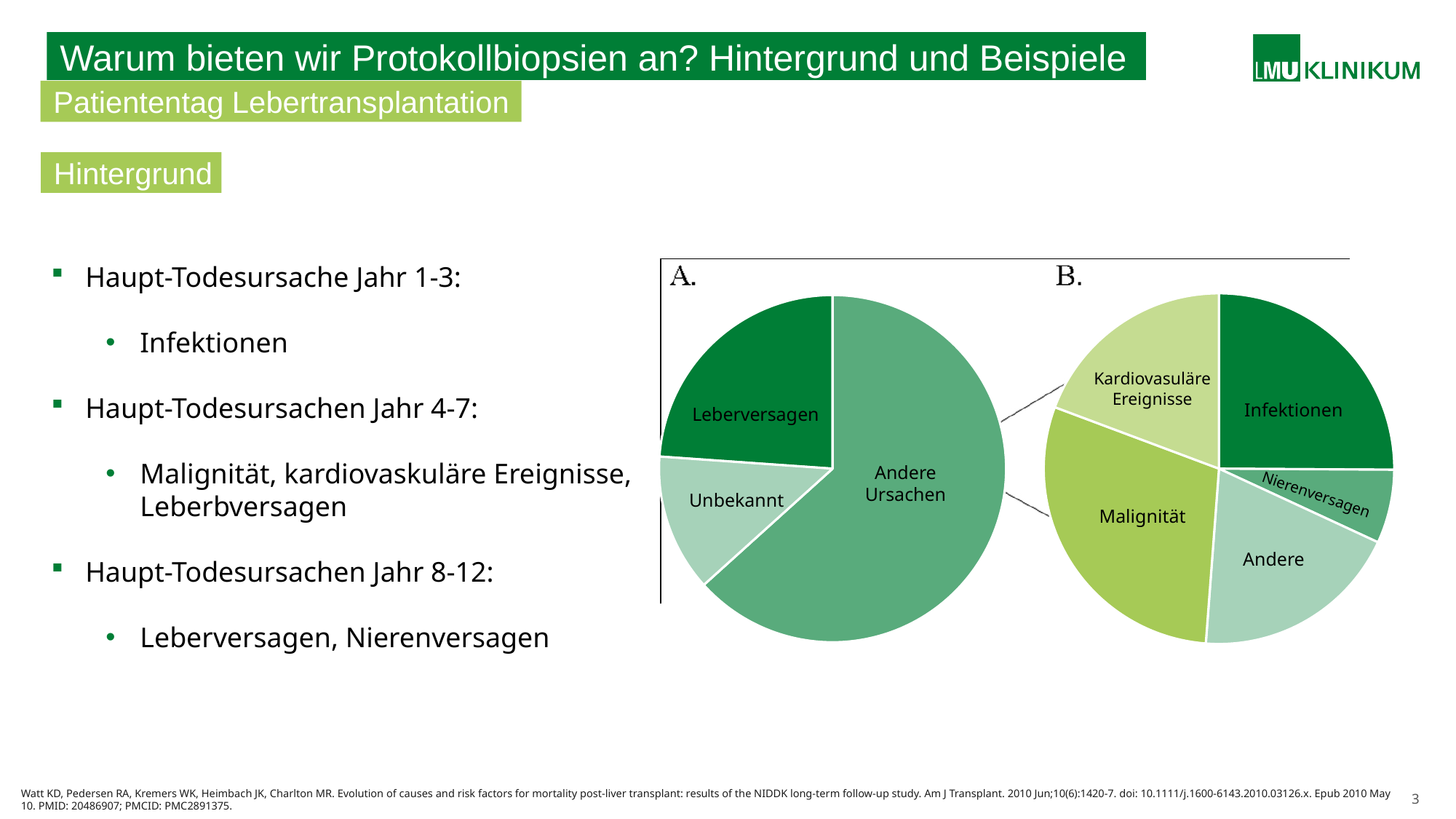
In chart A, how many slices does the pie have? 3 In chart B, what colour is the Infektionen slice? dark green In chart A, which slice is larger, Leberversagen or Unbekannt? Leberversagen In chart A, which category has the smallest slice? Unbekannt In chart A, which category has the largest slice? Andere Ursachen In chart B, which category has the smallest slice? Nierenversagen What kind of chart is chart B on the slide? pie chart In chart B, how many slices does the pie have? 5 What kind of chart is chart A on the slide? pie chart In chart B, which slice is larger, Infektionen or Nierenversagen? Infektionen In chart B, which slice is larger, Andere or Nierenversagen? Andere